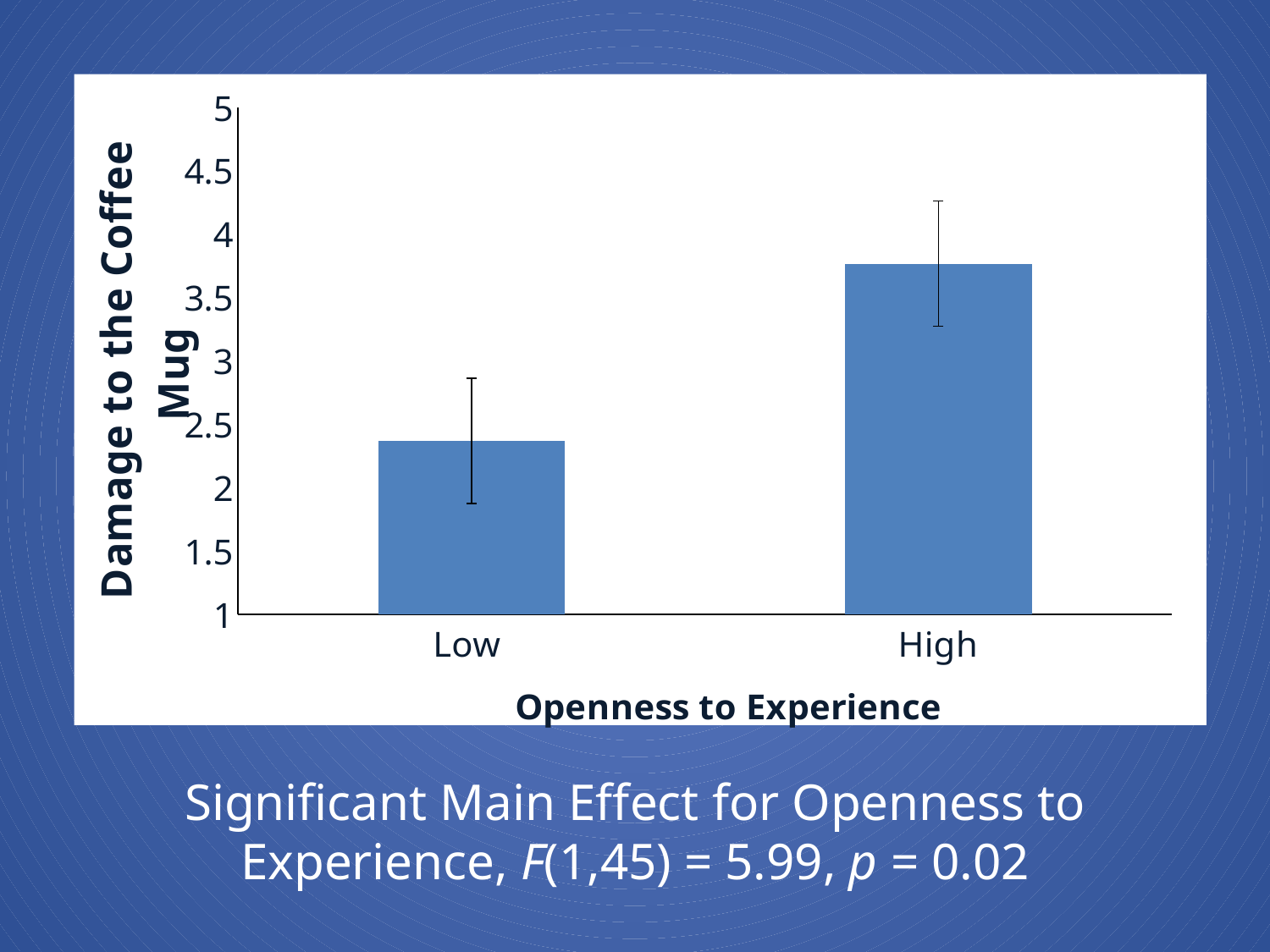
Which has a larger value, Low or High openness to experience? High What is the title of the y axis? Damage to the Coffee Mug Is the value for High greater or less than 3.5? greater Is the value for Low greater or less than 2? greater What is the title of the x axis? Openness to Experience Is the value for High greater or less than 4? less How many categories are plotted on the x axis? 2 Which category has the lowest damage to the coffee mug? Low Do the values rise or fall moving from Low to High along the x axis? rise Which category has the highest damage to the coffee mug? High What kind of chart is shown on the slide? bar chart